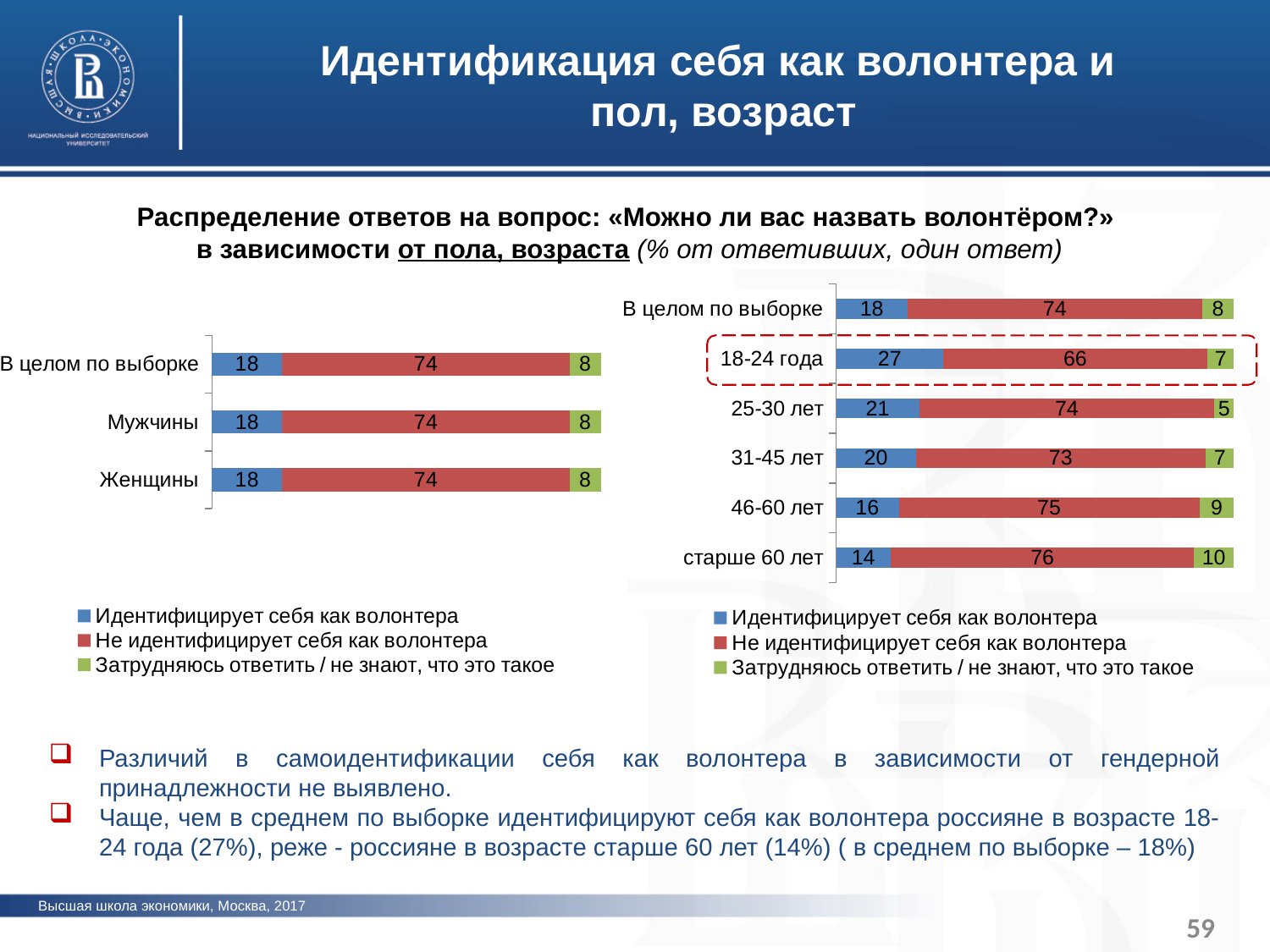
In the right-hand chart (by age), which age group is highlighted with a dashed red outline? 18-24 года In the right-hand chart (by age), what is the difference between the 'Идентифицирует себя как волонтера' values for '18-24 года' and 'старше 60 лет'? 13 In the right-hand chart (by age), what is the value for 'Идентифицирует себя как волонтера' for the '18-24 года' group? 27 In the right-hand chart (by age), what is the value for 'Не идентифицирует себя как волонтера' for the 'старше 60 лет' group? 76 What type of chart is the left-hand chart (by gender)? Stacked bar chart In the right-hand chart (by age), which age group has the highest value for 'Идентифицирует себя как волонтера'? 18-24 года In the right-hand chart (by age), which age group has the lowest value for 'Идентифицирует себя как волонтера'? старше 60 лет In the right-hand chart (by age), which is larger: the 'Затрудняюсь ответить / не знают, что это такое' value for '46-60 лет' or for '25-30 лет'? 46-60 лет In the right-hand chart (by age), what is the total of the stacked bar for '31-45 лет'? 100 How many series does the legend of the left-hand chart (by gender) list? 3 How many age groups (excluding 'В целом по выборке') are shown in the right-hand chart? 5 In the left-hand chart (by gender), what is the value for 'Затрудняюсь ответить / не знают, что это такое' for 'Женщины'? 8